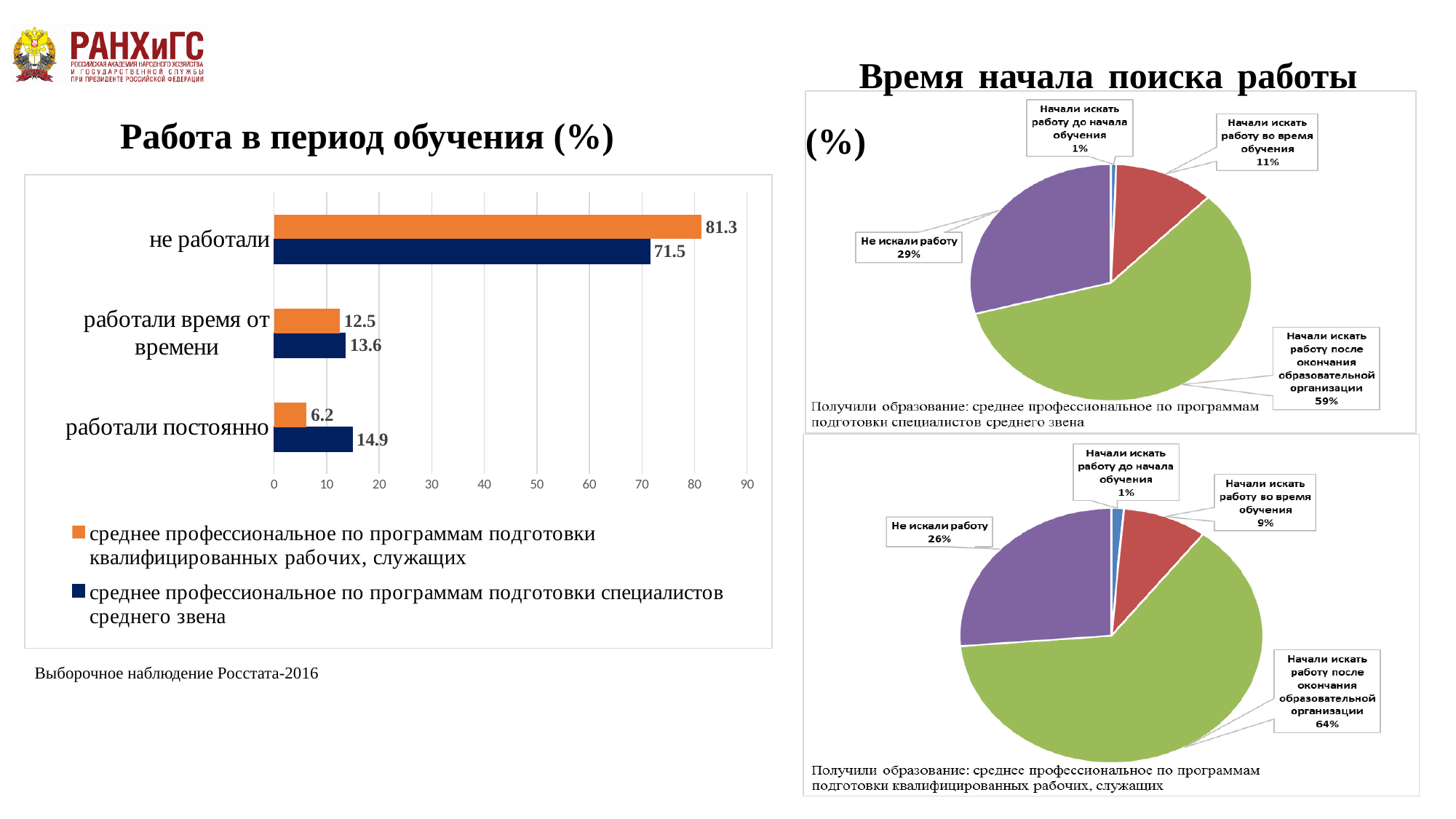
What kind of chart is 'Работа в период обучения (%)'? bar chart In the bar chart 'Работа в период обучения (%)', what is the difference between the two series' values for 'не работали'? 9.8 In the bar chart 'Работа в период обучения (%)', what is the value for 'работали постоянно' for the series 'среднее профессиональное по программам подготовки специалистов среднего звена'? 14.9 In the bar chart 'Работа в период обучения (%)', which category has the lowest value for the orange series? работали постоянно In the bottom pie chart (квалифицированных рабочих, служащих), which slice is the largest? Начали искать работу после окончания образовательной организации In the top pie chart (специалистов среднего звена), what share is 'Начали искать работу во время обучения'? 11% In the bottom pie chart (квалифицированных рабочих, служащих), what share is 'Не искали работу'? 26% In the bar chart 'Работа в период обучения (%)', which series has the larger value for 'работали постоянно'? среднее профессиональное по программам подготовки специалистов среднего звена In the bar chart 'Работа в период обучения (%)', what is the value for 'не работали' for the series 'среднее профессиональное по программам подготовки квалифицированных рабочих, служащих'? 81.3 How many series does the legend of the bar chart 'Работа в период обучения (%)' list? 2 In the top pie chart (специалистов среднего звена), what share is 'Начали искать работу после окончания образовательной организации'? 59% How many categories are shown in the bar chart 'Работа в период обучения (%)'? 3